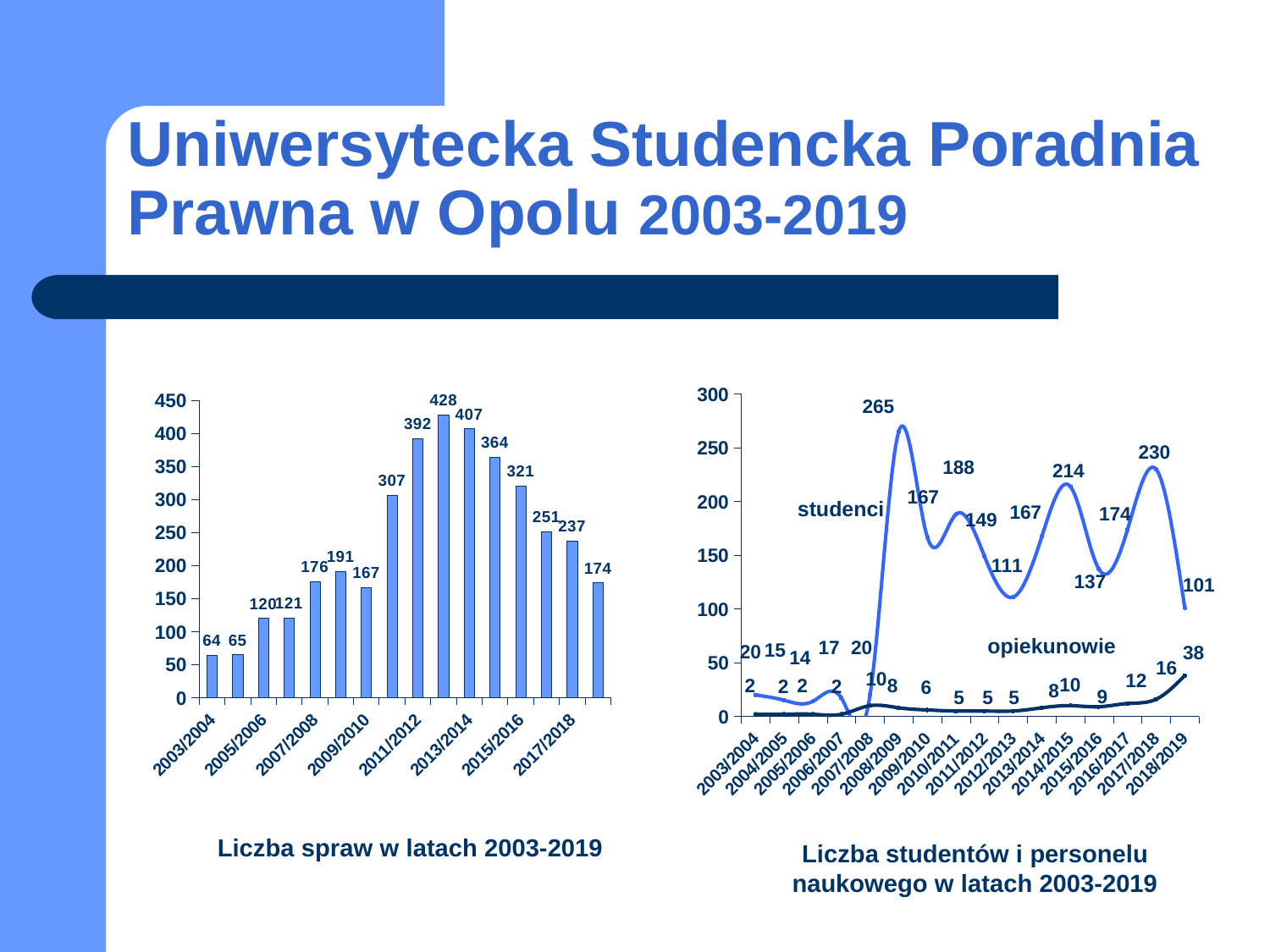
In the left chart 'Liczba spraw w latach 2003-2019', what is the value for 2011/2012? 392 In the left chart 'Liczba spraw w latach 2003-2019', what is the value for 2003/2004? 64 What kind of chart is the left chart, 'Liczba spraw w latach 2003-2019'? bar chart How many bars are in the left chart 'Liczba spraw w latach 2003-2019'? 16 In the left chart 'Liczba spraw w latach 2003-2019', what is the highest value shown? 428 How many series are plotted in the right chart 'Liczba studentów i personelu naukowego w latach 2003-2019'? 2 In the left chart 'Liczba spraw w latach 2003-2019', what is the difference between the values for 2013/2014 and 2015/2016? 86 In the left chart 'Liczba spraw w latach 2003-2019', which is larger, the value for 2007/2008 or 2009/2010? 2007/2008 What kind of chart is the right chart, 'Liczba studentów i personelu naukowego w latach 2003-2019'? line chart In the right chart 'Liczba studentów i personelu naukowego w latach 2003-2019', what is the highest value of the 'studenci' series? 265 In the right chart 'Liczba studentów i personelu naukowego w latach 2003-2019', what is the value of 'studenci' for 2012/2013? 111 In the right chart 'Liczba studentów i personelu naukowego w latach 2003-2019', what is the value of 'opiekunowie' for 2018/2019? 38